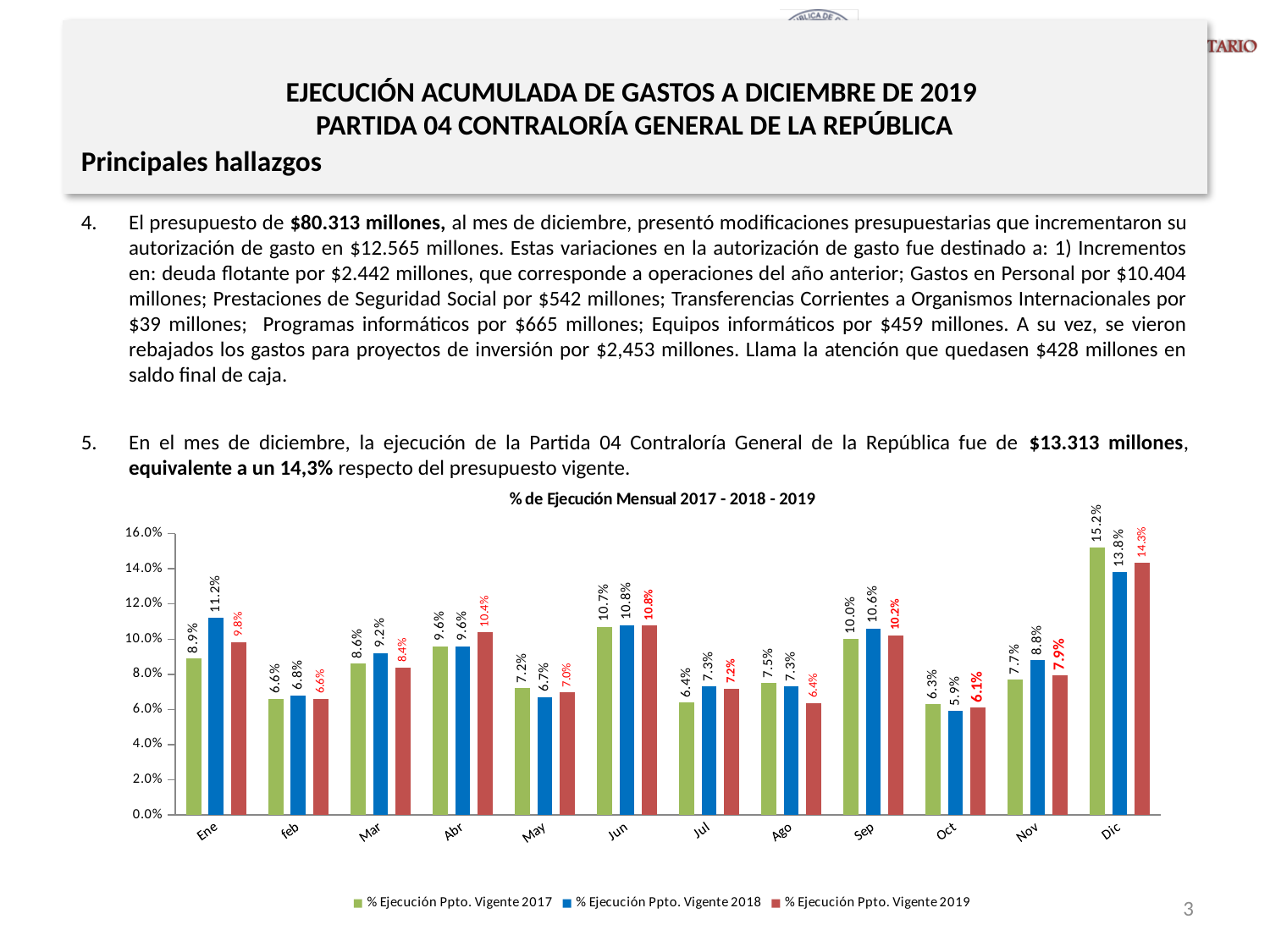
What is the value for Ene in the % Ejecución Ppto. Vigente 2018 series? 11.2% How many months are shown on the x axis of the chart? 12 What is the difference between the 2017 and 2019 values for Dic? 0.9% What is the value for Abr in the % Ejecución Ppto. Vigente 2017 series? 9.6% What is the title of the chart? % de Ejecución Mensual 2017 - 2018 - 2019 Which month has the lowest value in the % Ejecución Ppto. Vigente 2018 series? Oct What kind of chart is shown on the slide? Bar chart For Ago, which series has the larger value: % Ejecución Ppto. Vigente 2017 or % Ejecución Ppto. Vigente 2019? % Ejecución Ppto. Vigente 2017 What is the value for Dic in the % Ejecución Ppto. Vigente 2019 series? 14.3% How many series does the legend list? 3 Is the value for Sep in the % Ejecución Ppto. Vigente 2018 series greater or less than 10.0%? greater Which month has the highest value in the % Ejecución Ppto. Vigente 2017 series? Dic